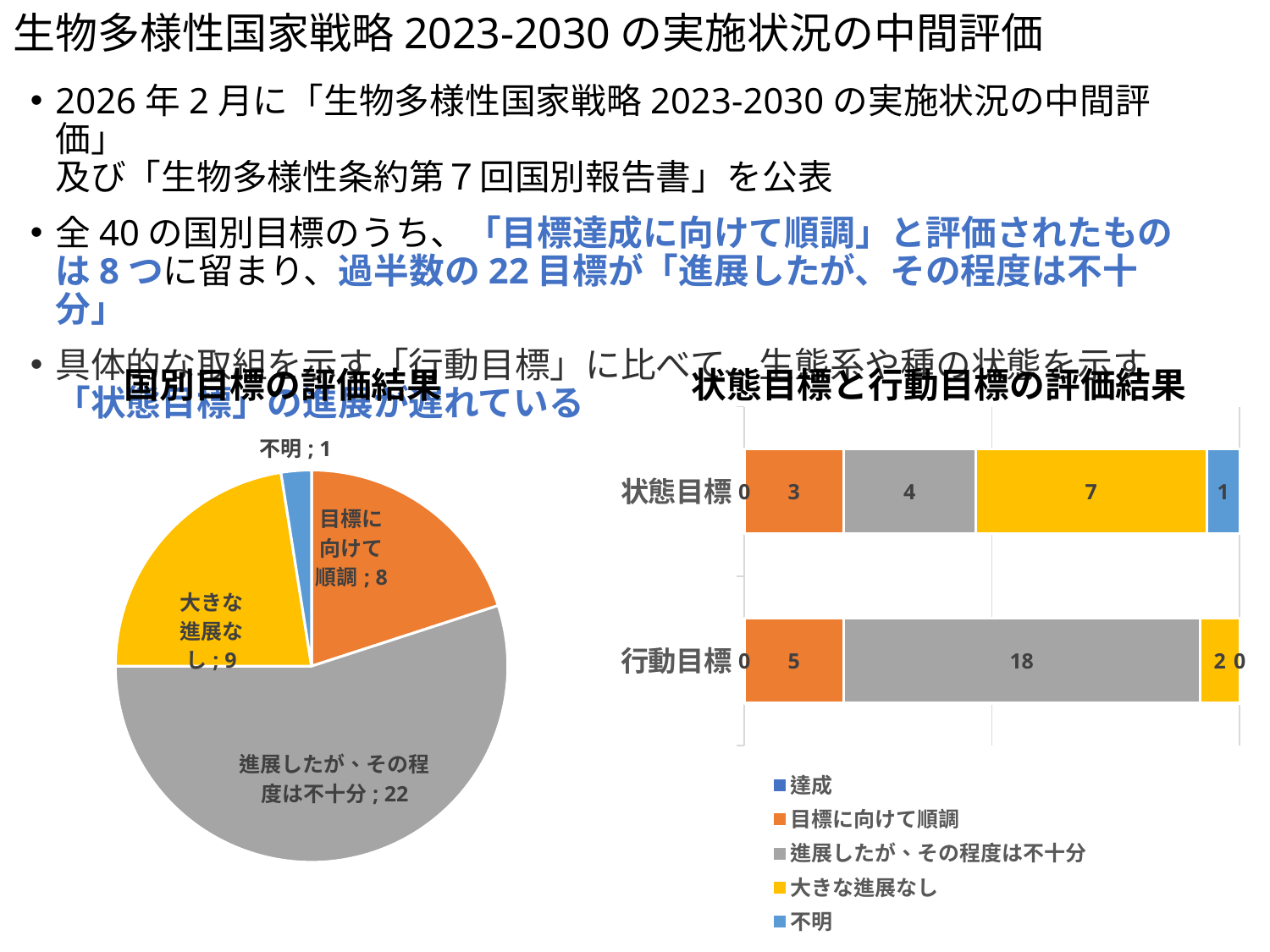
「状態目標と行動目標の評価結果」のグラフで、「目標に向けて順調」の値は状態目標と行動目標のどちらが大きいですか？ 行動目標 「状態目標と行動目標の評価結果」のグラフで、行動目標の「進展したが、その程度は不十分」の値はいくつですか？ 18 「国別目標の評価結果」の円グラフで、「目標に向けて順調」は全体の何パーセントを占めますか？ 20% 「国別目標の評価結果」の円グラフで、「進展したが、その程度は不十分」の値はいくつですか？ 22 「国別目標の評価結果」の円グラフで、最も大きい区分はどれですか？ 進展したが、その程度は不十分 「国別目標の評価結果」の円グラフで、「大きな進展なし」と「目標に向けて順調」の差はいくつですか？ 1 「状態目標と行動目標の評価結果」のグラフで、行動目標の合計はいくつですか？ 25 「国別目標の評価結果」の円グラフで、最も小さい区分はどれですか？ 不明 「状態目標と行動目標の評価結果」のグラフで、状態目標の「大きな進展なし」の値はいくつですか？ 7 「状態目標と行動目標の評価結果」のグラフの凡例には何系列ありますか？ 5 「状態目標と行動目標の評価結果」のグラフで、状態目標の合計はいくつですか？ 15 「国別目標の評価結果」の円グラフは何種類のグラフですか？ 円グラフ